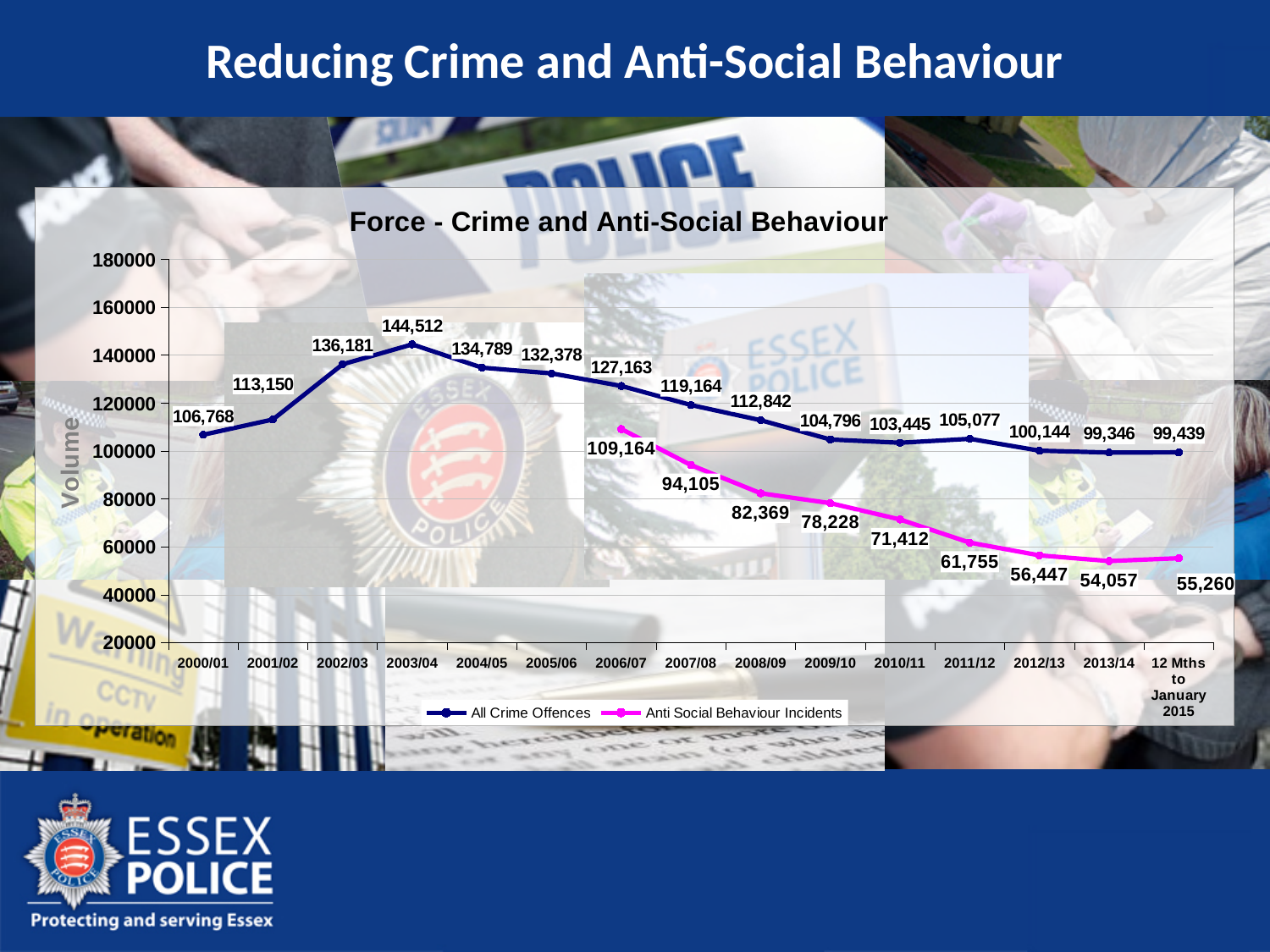
Do Anti Social Behaviour Incidents rise or fall from 2006/07 to 2013/14? fall How many time periods are shown on the x axis? 15 In 2006/07, which series has the larger value, All Crime Offences or Anti Social Behaviour Incidents? All Crime Offences What is the value for All Crime Offences in 2003/04? 144,512 In which year is the All Crime Offences series at its highest? 2003/04 Is the value for All Crime Offences in 2001/02 greater or less than 120000? less By how much did Anti Social Behaviour Incidents fall from 2006/07 to the 12 Mths to January 2015? 53,904 What is the value for Anti Social Behaviour Incidents in 2010/11? 71,412 How many series does the legend list? 2 What is the difference between All Crime Offences in 2003/04 and in 2000/01? 37,744 What kind of chart is shown on the slide? line chart In which year is the Anti Social Behaviour Incidents series at its lowest? 2013/14